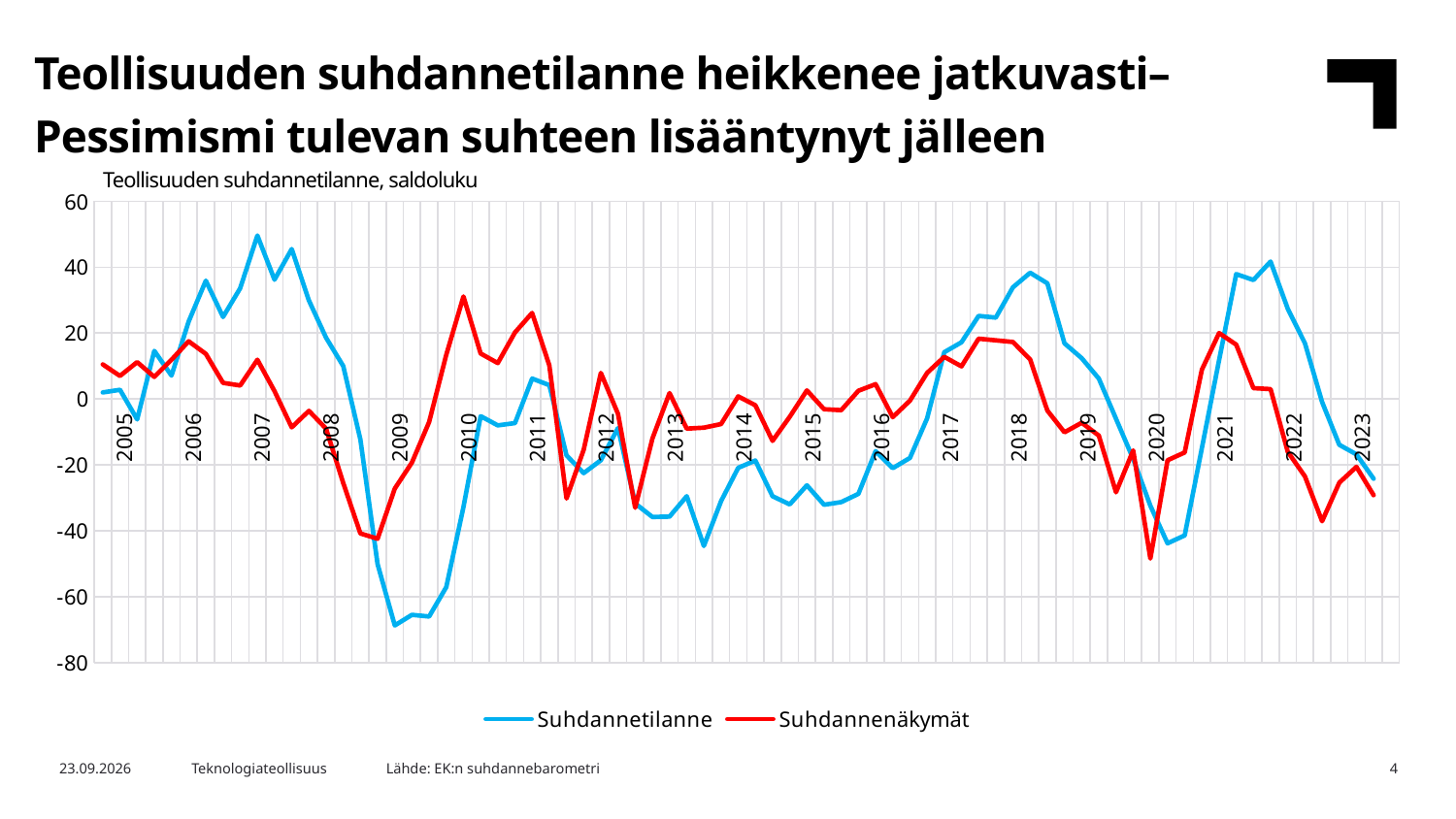
Is the peak of the Suhdannenäkymät series around 2010 greater or less than 20? greater How many series does the legend list? 2 How many year labels are shown on the x axis? 19 Which series reaches the highest value anywhere on the chart? Suhdannetilanne What is the title printed above the chart? Teollisuuden suhdannetilanne, saldoluku Is the peak of the Suhdannetilanne series in 2007 greater or less than 40? greater Which series reaches the lowest value anywhere on the chart? Suhdannetilanne Is the lowest value of the Suhdannetilanne series (around 2009) greater or less than -60? less Does the Suhdannetilanne series rise or fall from its 2021 peak to 2023? fall What are the two series named in the legend? Suhdannetilanne and Suhdannenäkymät What kind of chart is shown on the slide? line chart